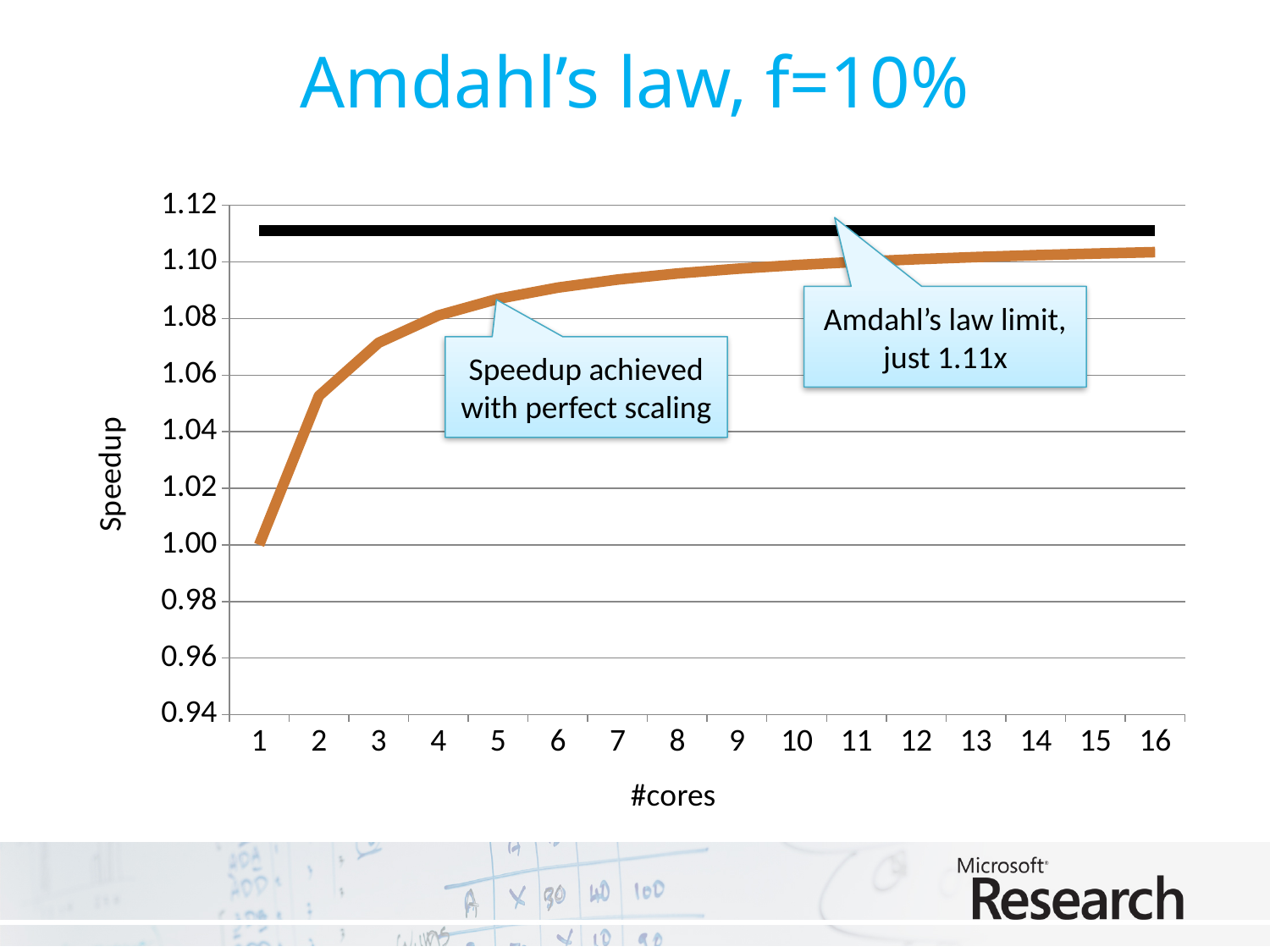
Which has the larger speedup, 2 cores or 3 cores? 3 cores Does the speedup rise or fall as the number of cores increases? rises How many core counts are plotted along the x axis? 16 Is the speedup at 3 cores greater or less than 1.06? greater Is the speedup at 8 cores greater or less than 1.08? greater Is the speedup at 2 cores greater or less than 1.04? greater According to the callout, what is the Amdahl's law limit on speedup? 1.11x What is the speedup at 1 core? 1.00 What is the title of the chart? Amdahl's law, f=10% What is the label of the x axis? #cores At which number of cores is the speedup highest? 16 What kind of chart is shown on the slide? line chart